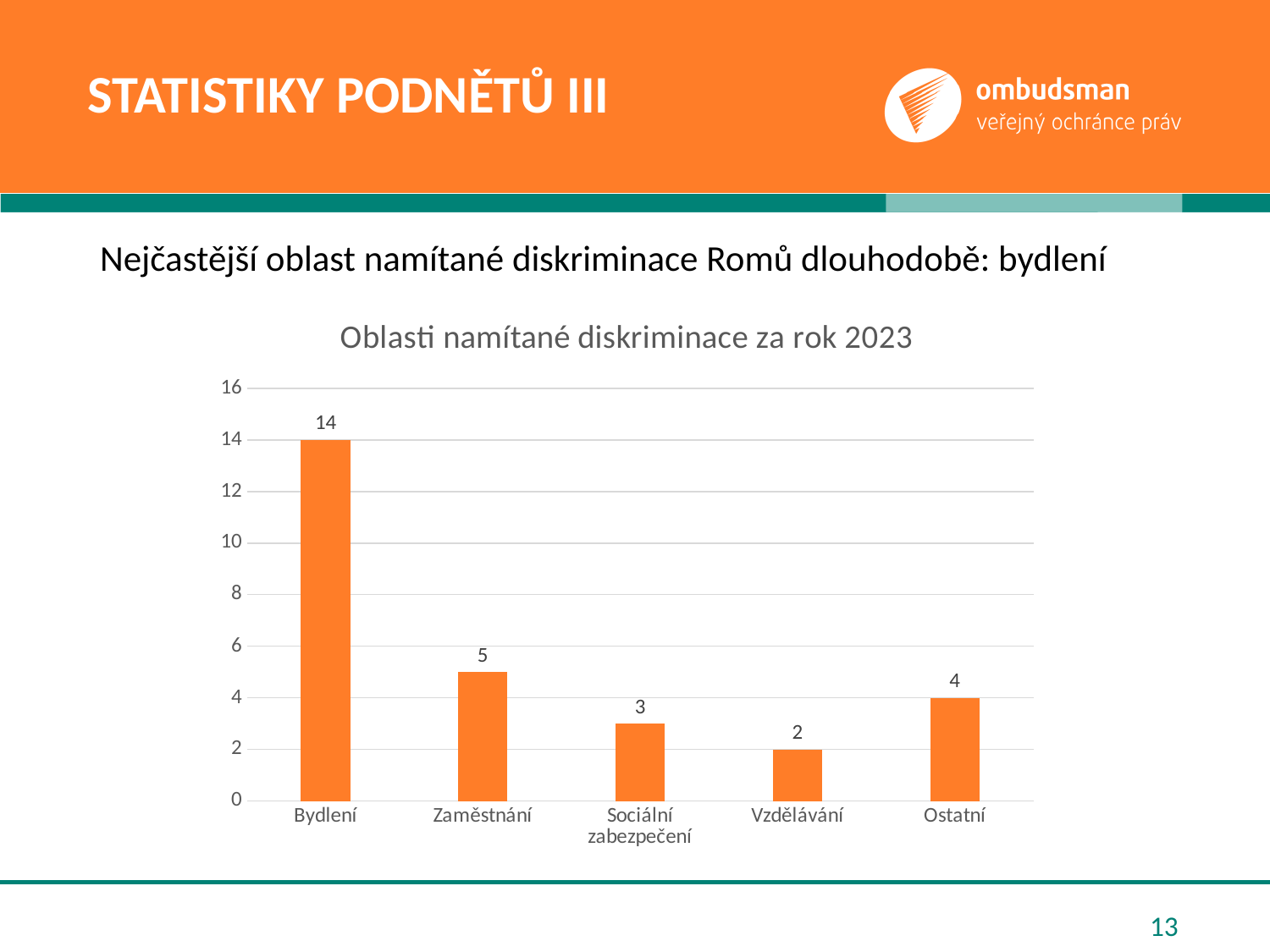
Which category has the lowest value? Vzdělávání What is the value for Ostatní? 4 What is the value for Bydlení? 14 What is the value for Sociální zabezpečení? 3 How many categories are shown in the chart? 5 What is the difference between the values for Bydlení and Zaměstnání? 9 What is the value for Zaměstnání? 5 Which category has the highest value? Bydlení What is the title of the chart? Oblasti namítané diskriminace za rok 2023 What is the value for Vzdělávání? 2 Which is larger, the value for Ostatní or the value for Sociální zabezpečení? Ostatní What kind of chart is shown on the slide? Bar chart